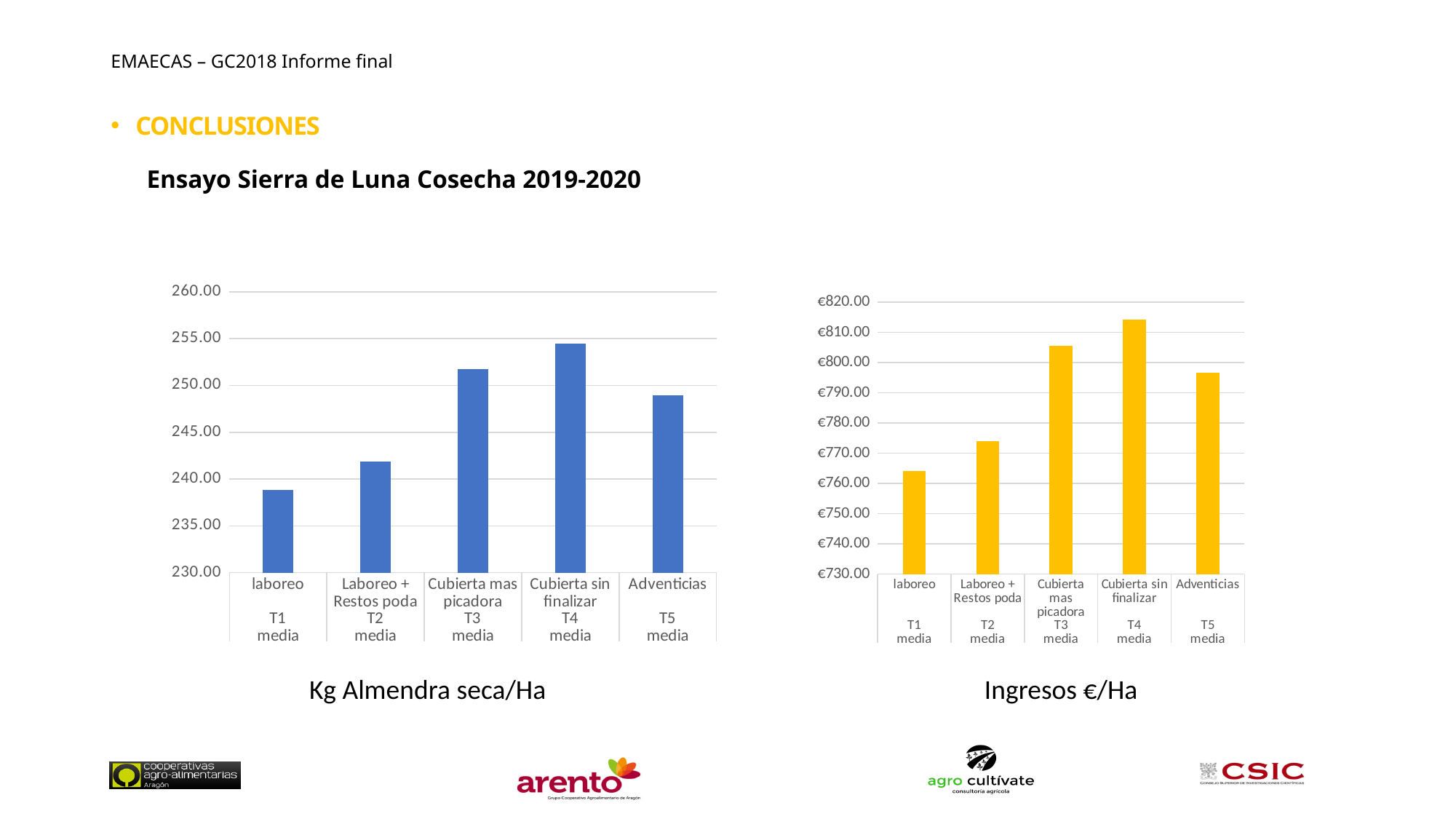
What colour are the bars in the right chart (Ingresos €/Ha)? yellow In the right chart (Ingresos €/Ha), which category has the highest value? Cubierta sin finalizar (T4 media) In the right chart (Ingresos €/Ha), which category has the lowest value? laboreo (T1 media) In the right chart (Ingresos €/Ha), which is larger: Adventicias (T5 media) or Laboreo + Restos poda (T2 media)? Adventicias (T5 media) How many categories are plotted in the left chart (Kg Almendra seca/Ha)? 5 In the right chart (Ingresos €/Ha), is the value for Cubierta mas picadora (T3 media) greater or less than €800.00? greater In the left chart (Kg Almendra seca/Ha), which category has the highest value? Cubierta sin finalizar (T4 media) In the left chart (Kg Almendra seca/Ha), is the value for laboreo (T1 media) greater or less than 240.00? less What kind of chart is the left chart captioned "Kg Almendra seca/Ha"? bar chart In the left chart (Kg Almendra seca/Ha), which is larger: Adventicias (T5 media) or Laboreo + Restos poda (T2 media)? Adventicias (T5 media) In the left chart (Kg Almendra seca/Ha), is the value for Cubierta mas picadora (T3 media) greater or less than 250.00? greater In the left chart (Kg Almendra seca/Ha), which category has the lowest value? laboreo (T1 media)